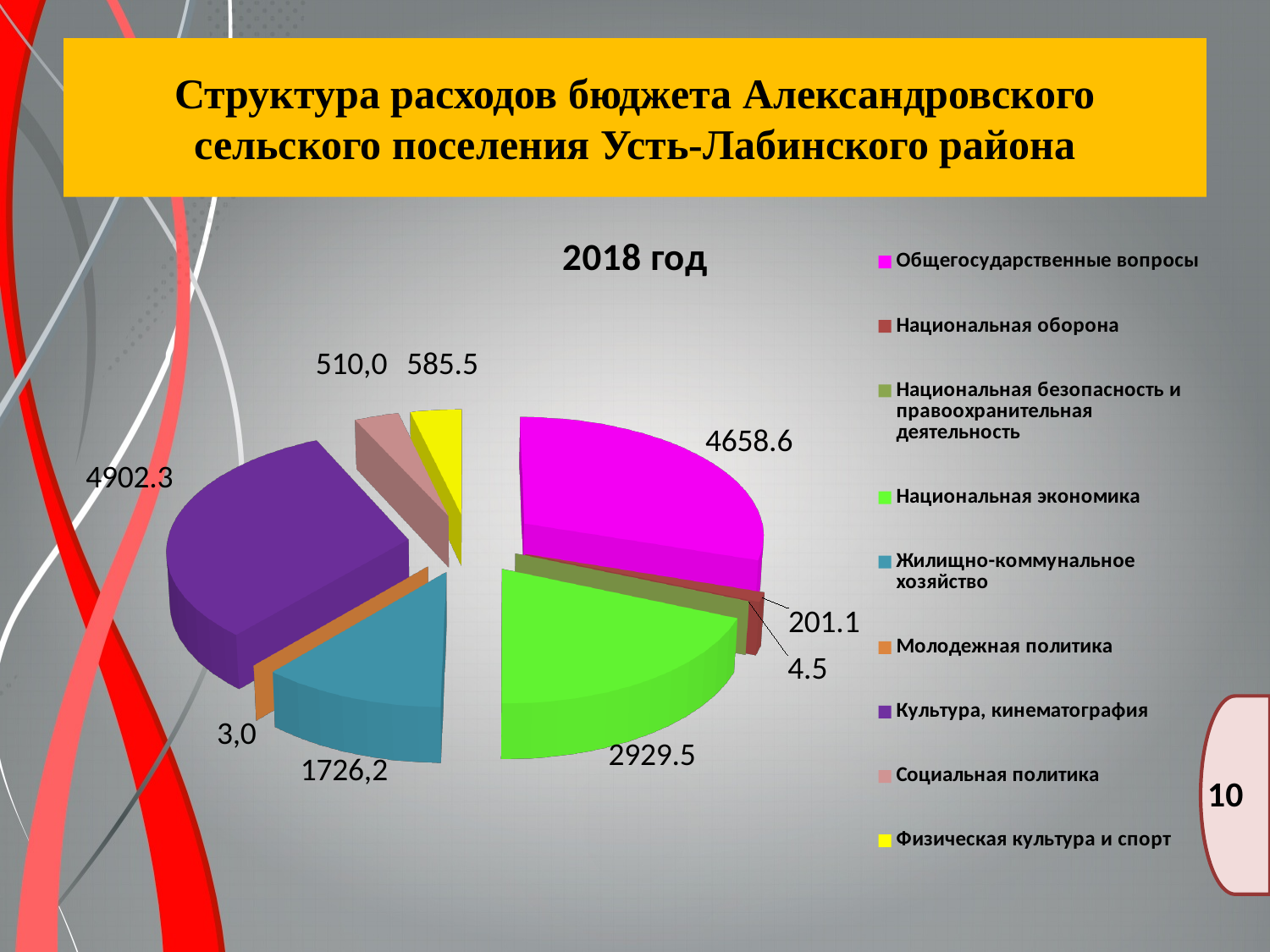
What is the difference between the values for Культура, кинематография and Общегосударственные вопросы? 243.7 What is the value shown for Социальная политика? 510,0 What kind of chart is shown on the slide? Pie chart Which category has the largest slice of the pie? Культура, кинематография Which category has the smallest value in the chart? Молодежная политика What is the value shown for Общегосударственные вопросы? 4658.6 What is the value shown for Национальная экономика? 2929.5 What is the value shown for Культура, кинематография? 4902.3 What is the value shown for Физическая культура и спорт? 585.5 How many categories does the legend list? 9 Which is larger: Национальная экономика or Жилищно-коммунальное хозяйство? Национальная экономика What is the value shown for Жилищно-коммунальное хозяйство? 1726,2